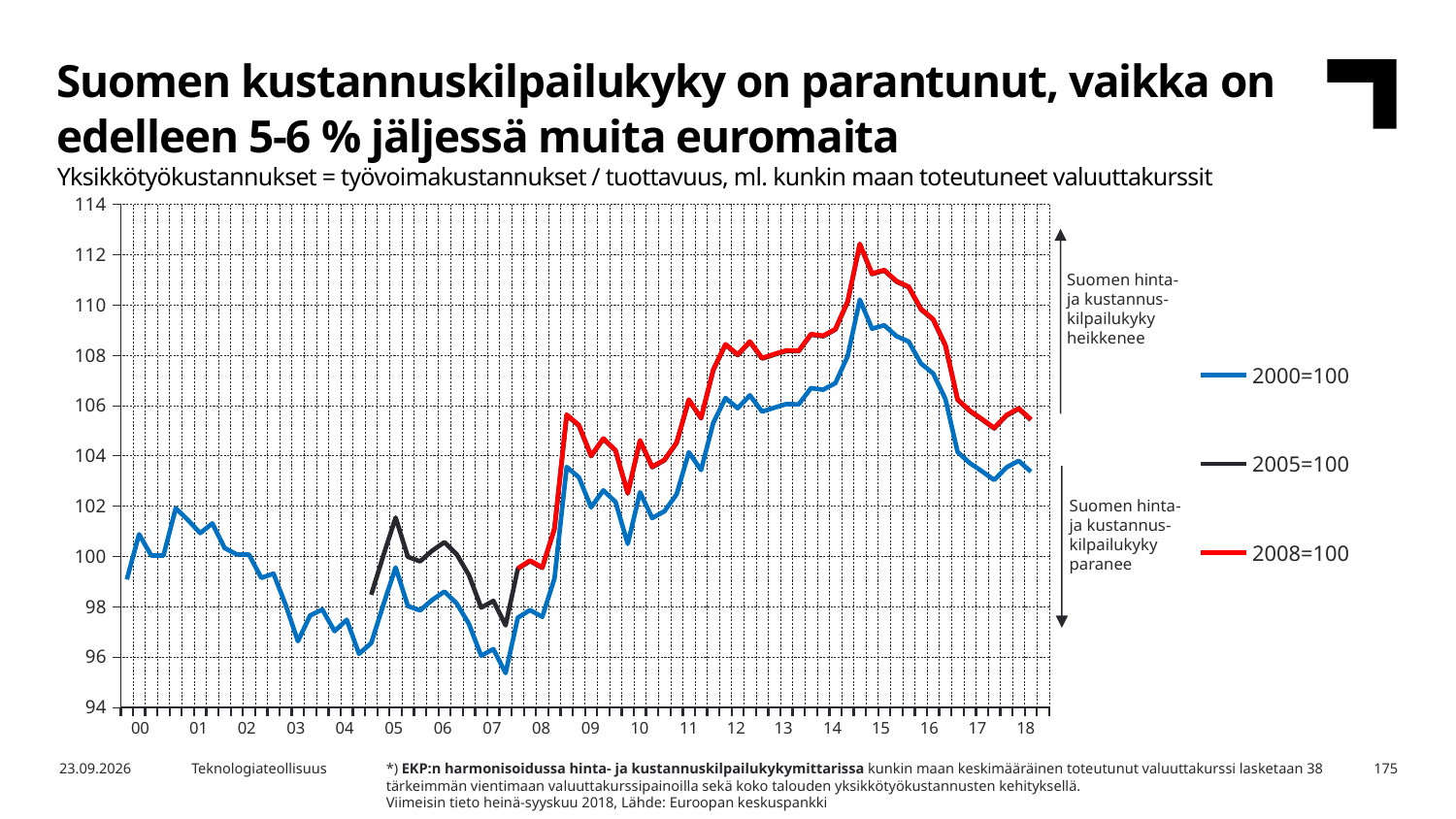
Is the lowest point of the 2000=100 series around 2003 greater or less than 98? less Does the 2000=100 series rise or fall between 2015 and 2017? fall Is the peak value of the 2008=100 series (around 2014–15) greater or less than 110? greater Is the value of the 2008=100 series at 2018 greater or less than 104? greater How many series does the legend list? 3 Which series reaches the highest value anywhere on the chart? 2008=100 Which series covers the shortest span of years on the chart? 2005=100 What are the three series named in the legend? 2000=100, 2005=100, 2008=100 What kind of chart is shown on the slide? line chart At 2012, which series is higher, 2000=100 or 2008=100? 2008=100